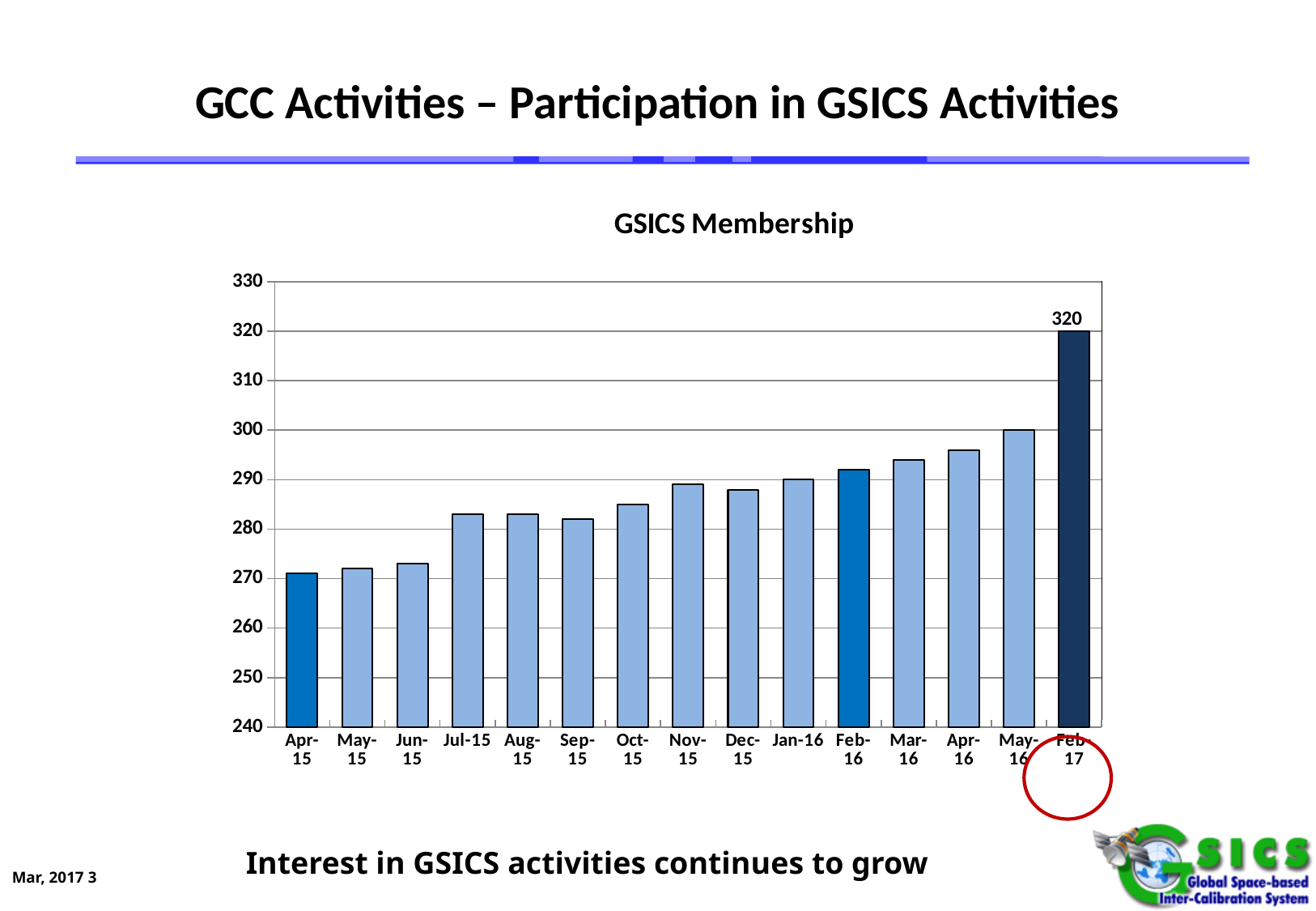
How many months (bars) are plotted in the chart? 15 Is the value for Mar-16 greater or less than 300? less Which month has the highest GSICS membership? Feb-17 What is the title of the chart? GSICS Membership Is the value for Apr-15 greater or less than 280? less What is the GSICS membership value for Feb-17? 320 Which month has the lowest GSICS membership? Apr-15 Do the membership values generally rise or fall from Apr-15 to Feb-17? rise Is the value for Feb-17 greater or less than 310? greater Which is larger, the value for Oct-15 or the value for Jun-15? Oct-15 What kind of chart is shown on the slide? bar chart